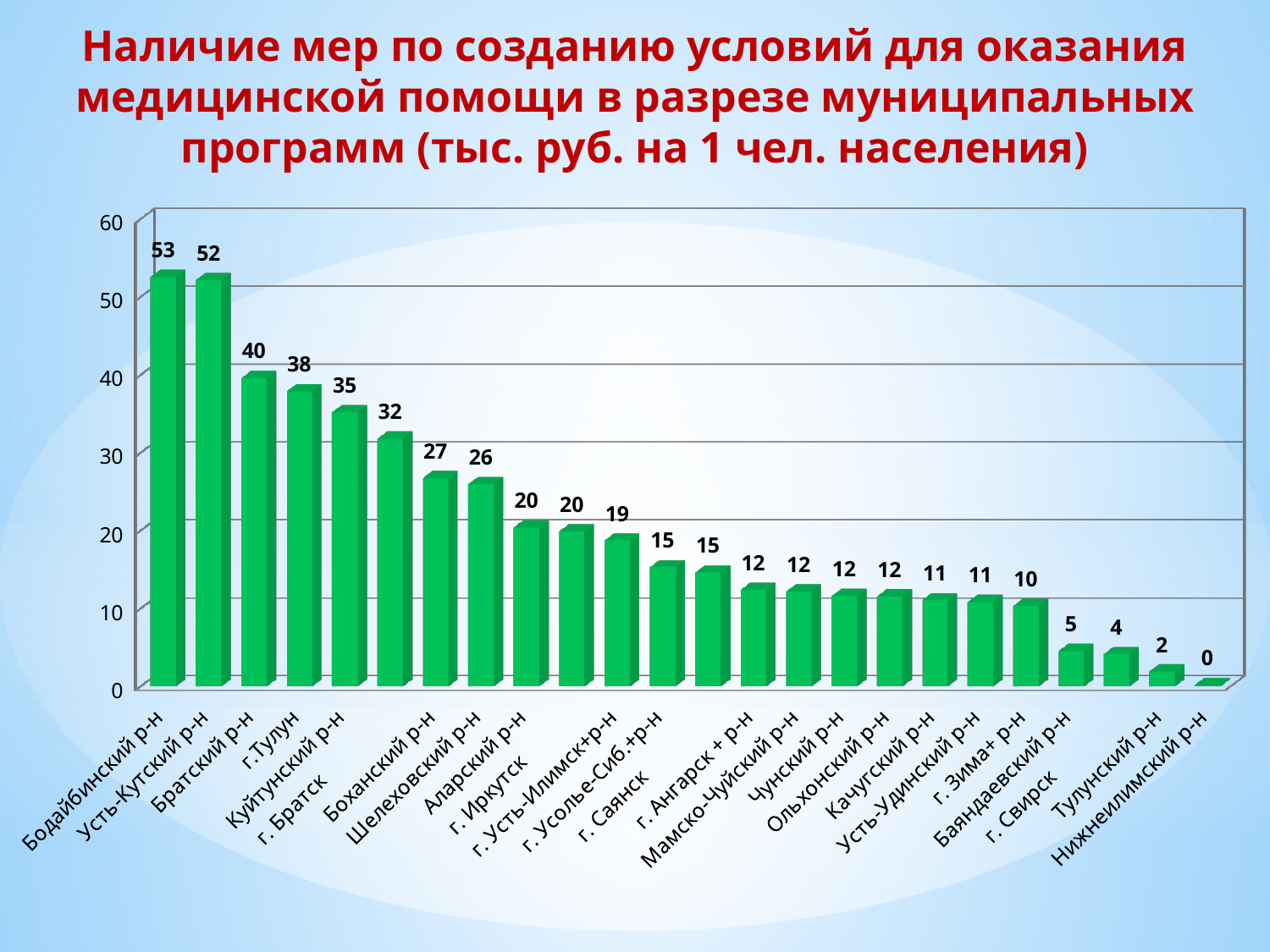
Do the values rise or fall from left to right along the x axis? fall How many categories are shown on the x axis? 24 Which category has the lowest value? Нижнеилимский р-н What is the value for г. Свирск? 4 What is the value for г. Иркутск? 20 Which category has the highest value? Бодайбинский р-н Which is larger, the value for Шелеховский р-н or the value for г. Саянск? Шелеховский р-н Is the value for г.Тулун greater or less than 30? greater What is the difference between the values for Братский р-н and г. Братск? 8 What is the value for Бодайбинский р-н? 53 What is the value for Куйтунский р-н? 35 What kind of chart is shown on the slide? bar chart